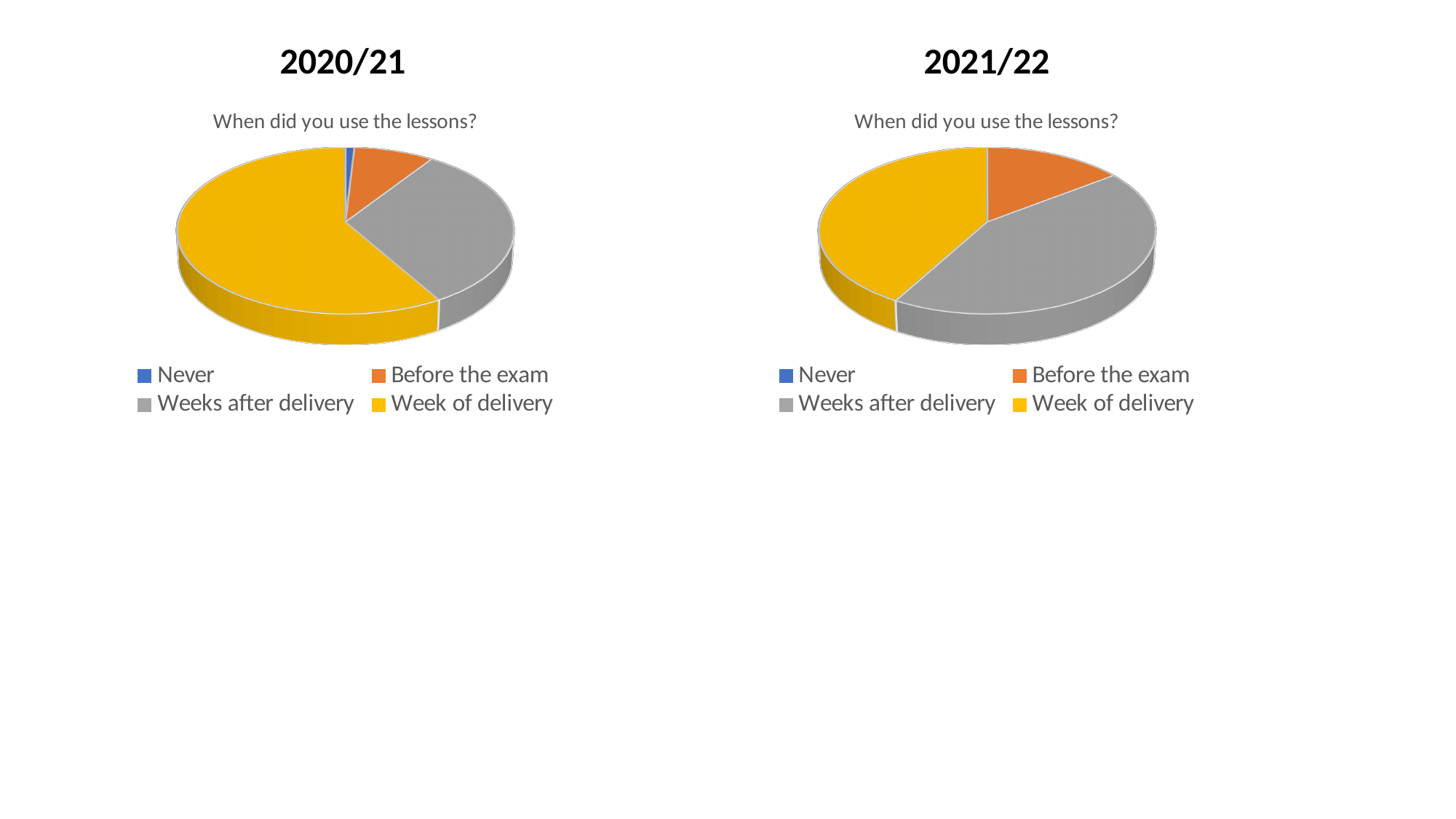
In the 2021/22 chart, which slice is larger: Before the exam or Week of delivery? Week of delivery In the 2020/21 chart, which category has the largest slice? Week of delivery In the 2021/22 chart, which slice is larger: Week of delivery or Weeks after delivery? Weeks after delivery In the 2020/21 chart, which colour represents Weeks after delivery? Grey What is the chart title shown above the 2021/22 pie? When did you use the lessons? What kind of chart is the 2021/22 chart? Pie chart In the 2020/21 chart, which category has the smallest slice? Never What kind of chart is the 2020/21 chart? Pie chart In the 2020/21 chart, which slice is larger: Before the exam or Weeks after delivery? Weeks after delivery In the 2021/22 chart, which category has the largest slice? Weeks after delivery How many categories does the legend of the 2020/21 chart list? 4